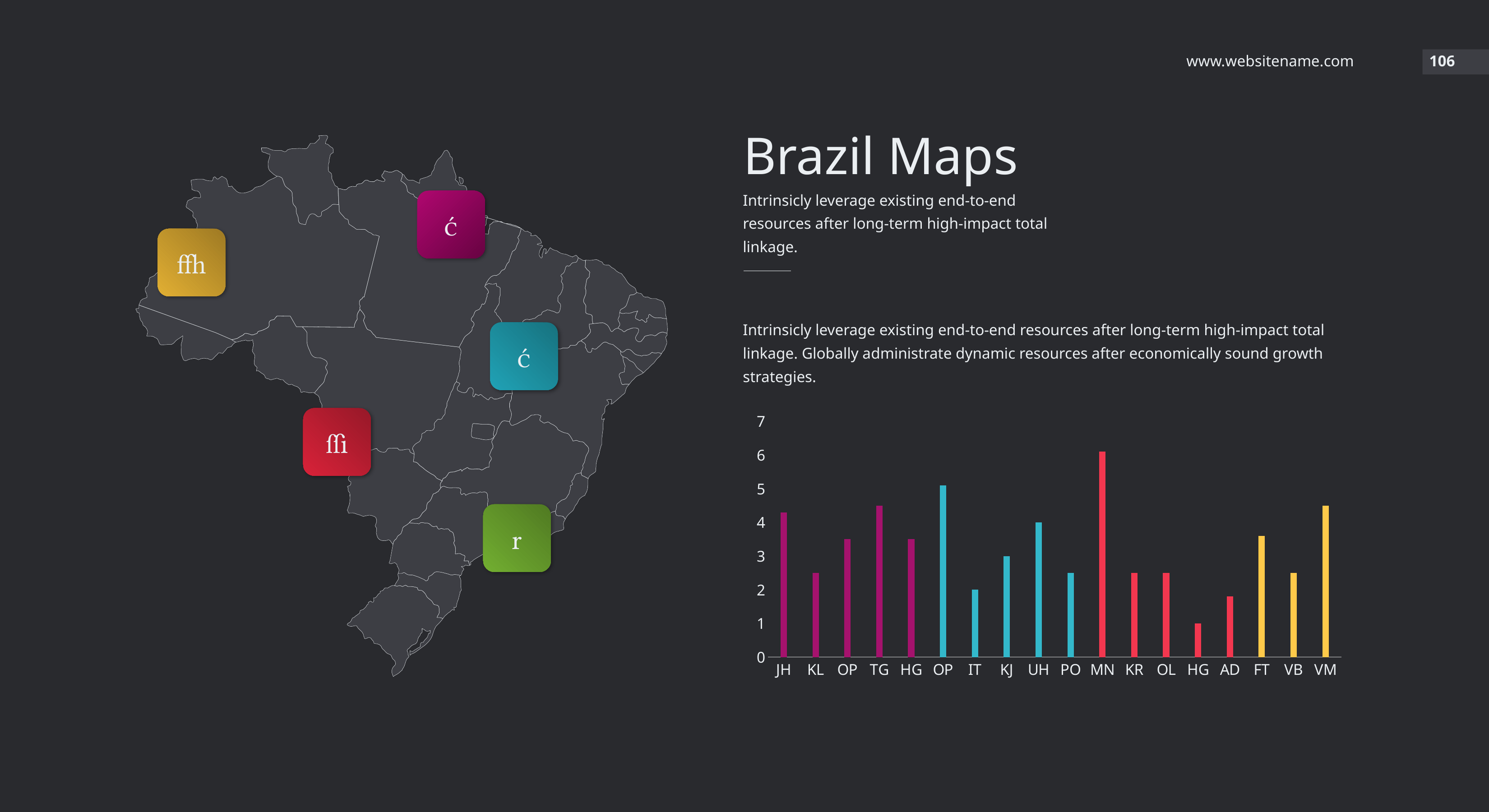
Which is larger, the value for MN or the value for VM? MN Is the value for VM greater or less than 4? greater Which category has the highest bar in the chart? MN Which category has the lowest bar in the chart? HG Is the value for KL greater or less than 3? less Which is larger, the value for UH or the value for IT? UH Is the value for MN greater or less than 5? greater What kind of chart is shown on the slide? bar chart How many categories are shown on the x axis of the bar chart? 18 What is the highest tick value shown on the y axis of the chart? 7